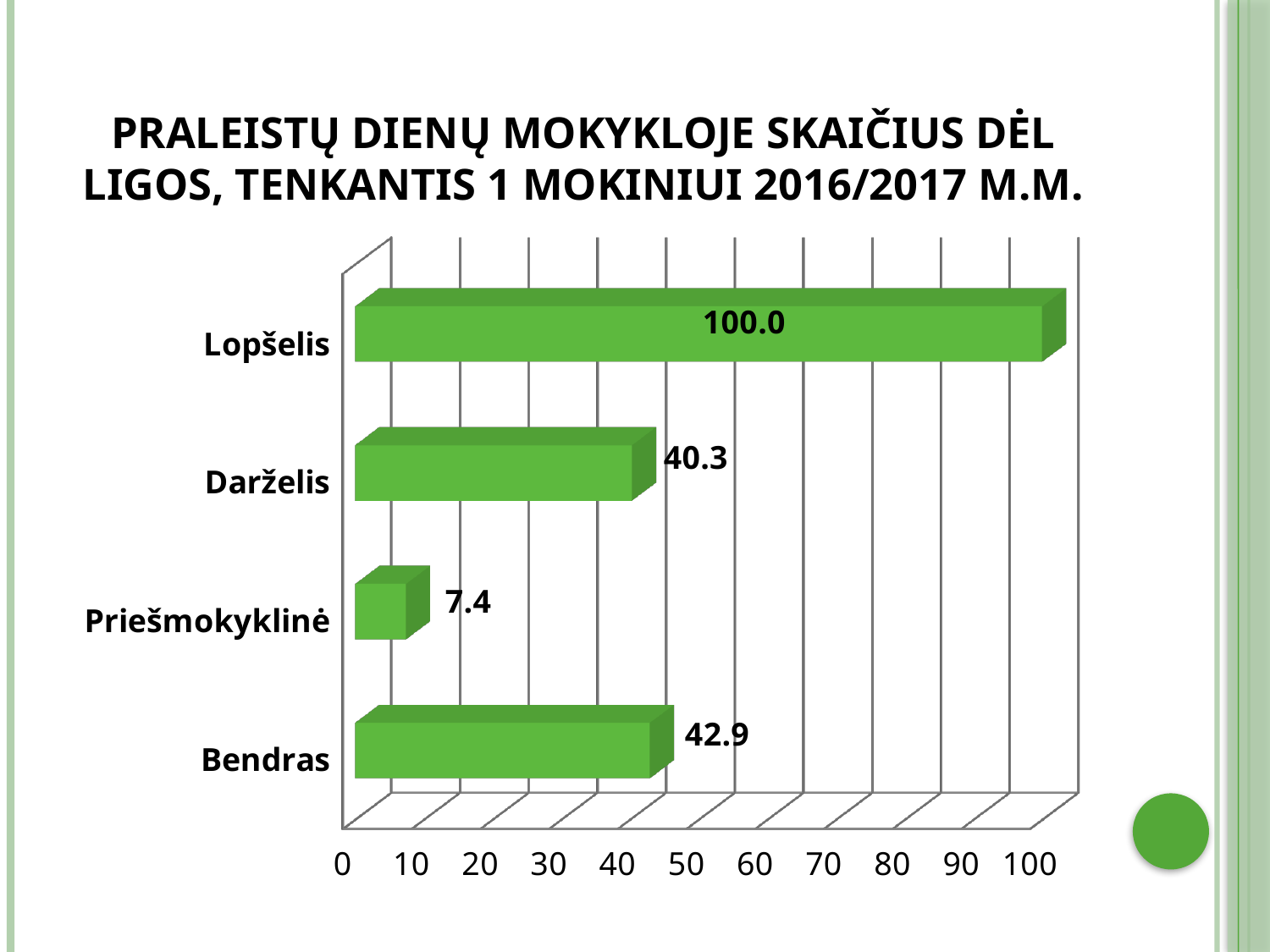
Which category has the lowest value? Priešmokyklinė What is the difference between the values for Bendras and Priešmokyklinė? 35.5 What is the value for Lopšelis? 100.0 What is the value for Priešmokyklinė? 7.4 Which is larger, the value for Bendras or the value for Darželis? Bendras What is the value for Darželis? 40.3 Which category has the highest value? Lopšelis How many categories are shown in the chart? 4 What is the difference between the values for Lopšelis and Darželis? 59.7 Is the value for Darželis greater or less than 50? less What kind of chart is shown on the slide? bar chart What is the value for Bendras? 42.9